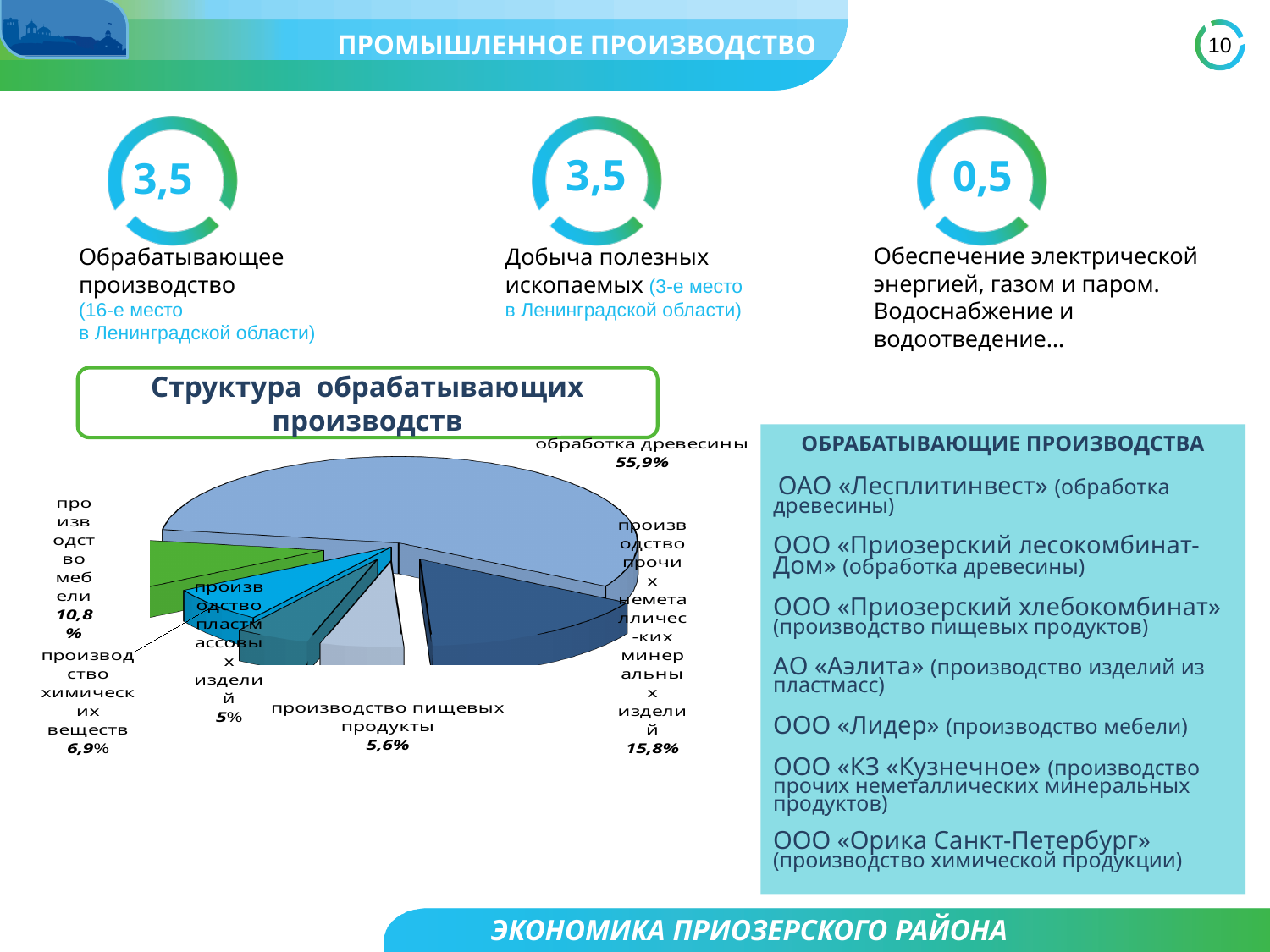
What kind of chart is shown under the title «Структура обрабатывающих производств»? pie chart In the pie chart, what share does «производство пищевых продуктов» have? 5,6% In the pie chart, what share does «производство пластмассовых изделий» have? 5% In the pie chart, what share does «обработка древесины» have? 55,9% In the pie chart, which is larger: «производство мебели» or «производство химических веществ»? производство мебели In the pie chart, what share does «производство мебели» have? 10,8% How many slices does the pie chart have? 6 Which slice of the pie chart is the smallest? производство пластмассовых изделий In the pie chart, what is the difference between the shares of «обработка древесины» and «производство прочих неметаллических минеральных изделий»? 40,1% In the pie chart, what share does «производство прочих неметаллических минеральных изделий» have? 15,8% In the pie chart, what share does «производство химических веществ» have? 6,9% Which slice of the pie chart is the largest? обработка древесины